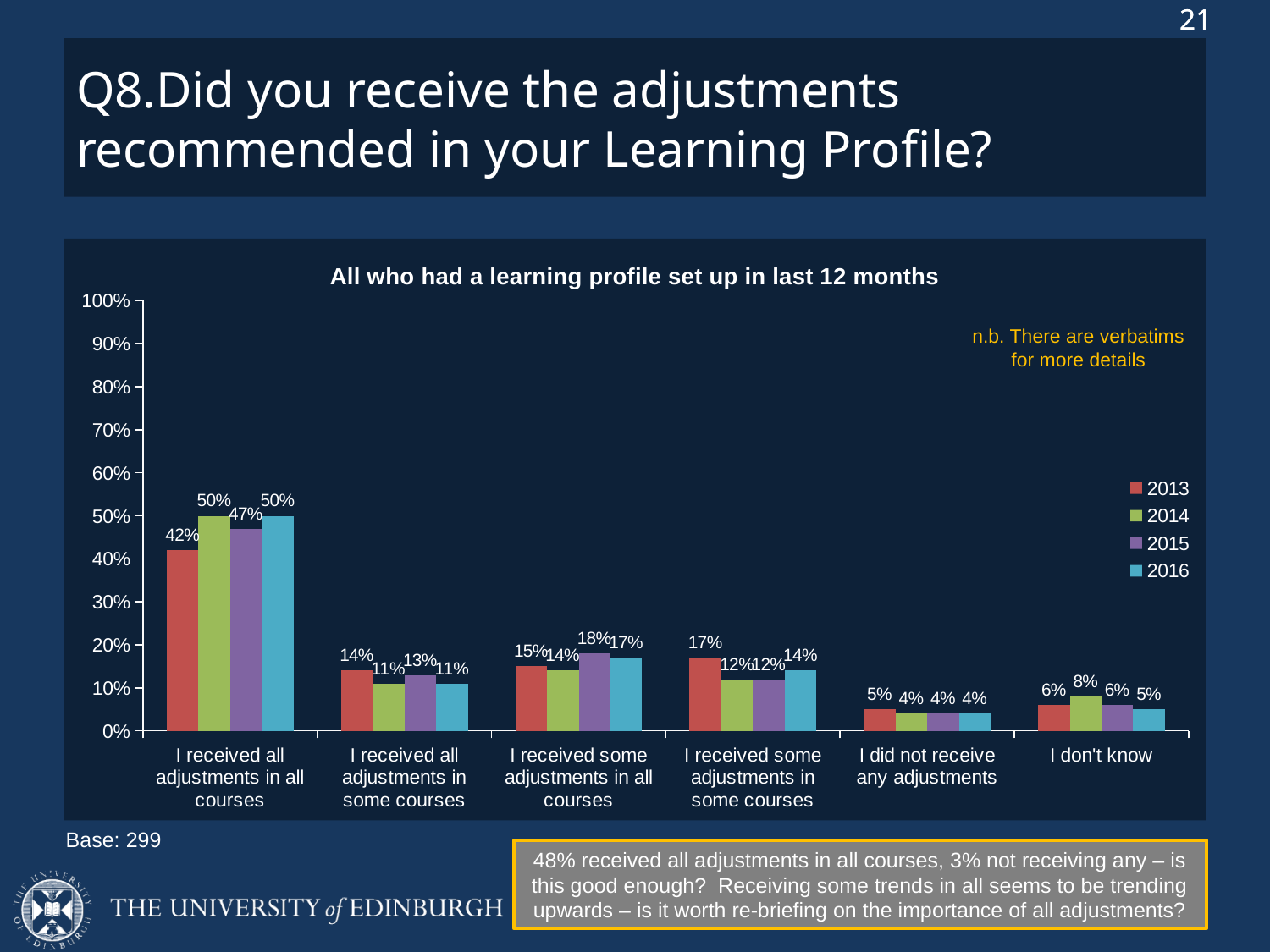
How many series does the legend list? 4 What kind of chart is shown on the slide? Bar chart What is the 2013 value for 'I received all adjustments in all courses'? 42% Which category has the lowest value for 2013? I did not receive any adjustments What is the 2014 value for 'I don't know'? 8% What is the title of the chart? All who had a learning profile set up in last 12 months How many categories are shown on the x axis? 6 For 'I received all adjustments in some courses', which is larger: the 2013 value or the 2014 value? 2013 What is the 2016 value for 'I received some adjustments in some courses'? 14% Which category has the highest value for 2016? I received all adjustments in all courses What is the difference between the 2014 and 2013 values for 'I received all adjustments in all courses'? 8% What is the 2015 value for 'I received some adjustments in all courses'? 18%